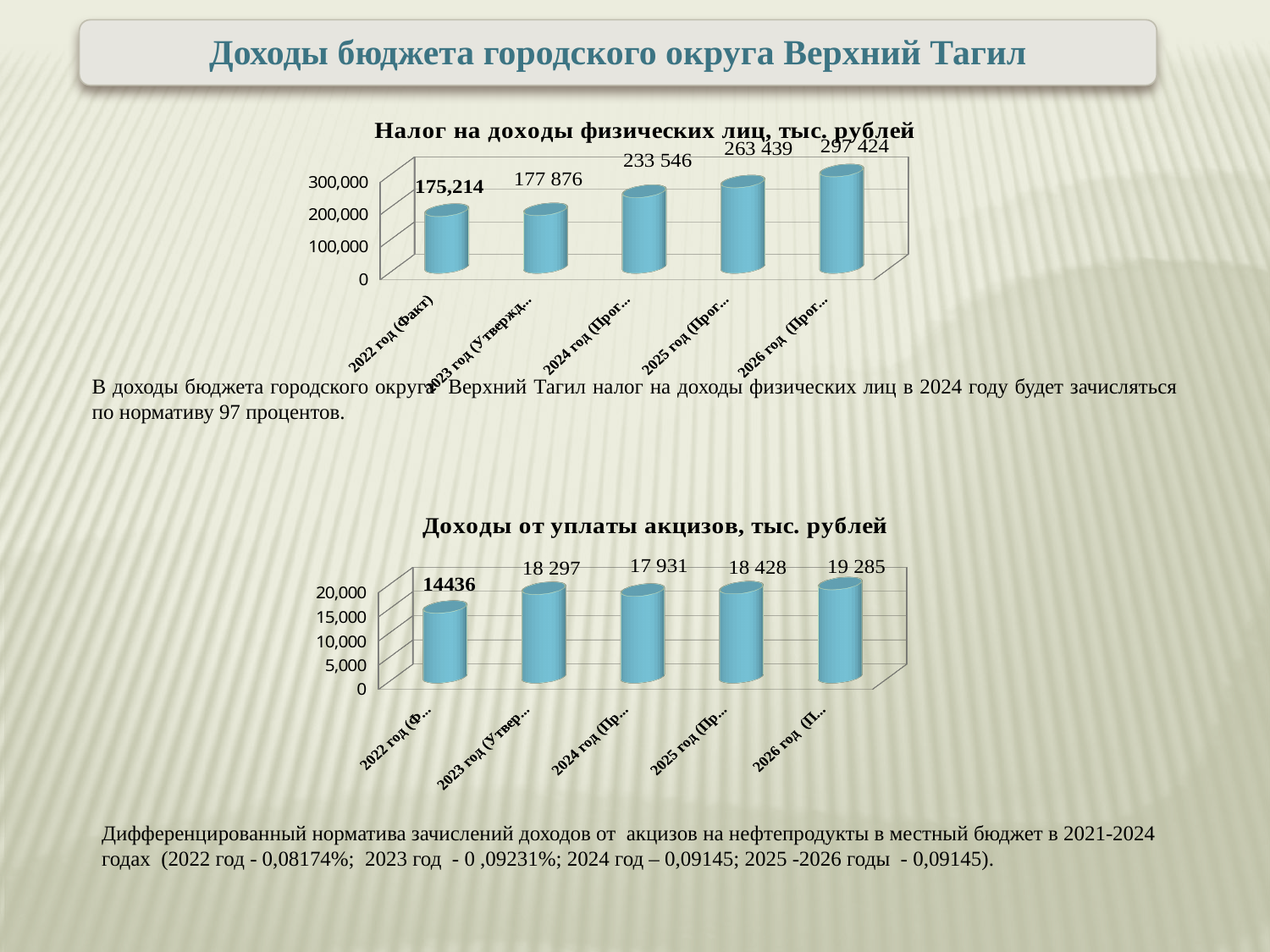
In the chart 'Налог на доходы физических лиц, тыс. рублей', what is the difference between the 2026 and 2022 values? 122 210 In the chart 'Налог на доходы физических лиц, тыс. рублей', what is the value for 2024 год? 233 546 In the chart 'Доходы от уплаты акцизов, тыс. рублей', what is the value for 2025 год? 18 428 In the chart 'Доходы от уплаты акцизов, тыс. рублей', which is larger, the value for 2023 or for 2024? 2023 In the chart 'Налог на доходы физических лиц, тыс. рублей', what is the value for 2022 год (Факт)? 175,214 In the chart 'Доходы от уплаты акцизов, тыс. рублей', which year has the lowest value? 2022 год In the chart 'Налог на доходы физических лиц, тыс. рублей', do the values rise or fall from 2022 to 2026? rise In the chart 'Доходы от уплаты акцизов, тыс. рублей', what is the difference between the 2026 and 2022 values? 4 849 How many bars are in the chart 'Налог на доходы физических лиц, тыс. рублей'? 5 What type of chart is the bottom chart 'Доходы от уплаты акцизов, тыс. рублей'? bar chart In the chart 'Доходы от уплаты акцизов, тыс. рублей', is the value for 2022 greater or less than 15,000? less In the chart 'Налог на доходы физических лиц, тыс. рублей', which year has the highest value? 2026 год